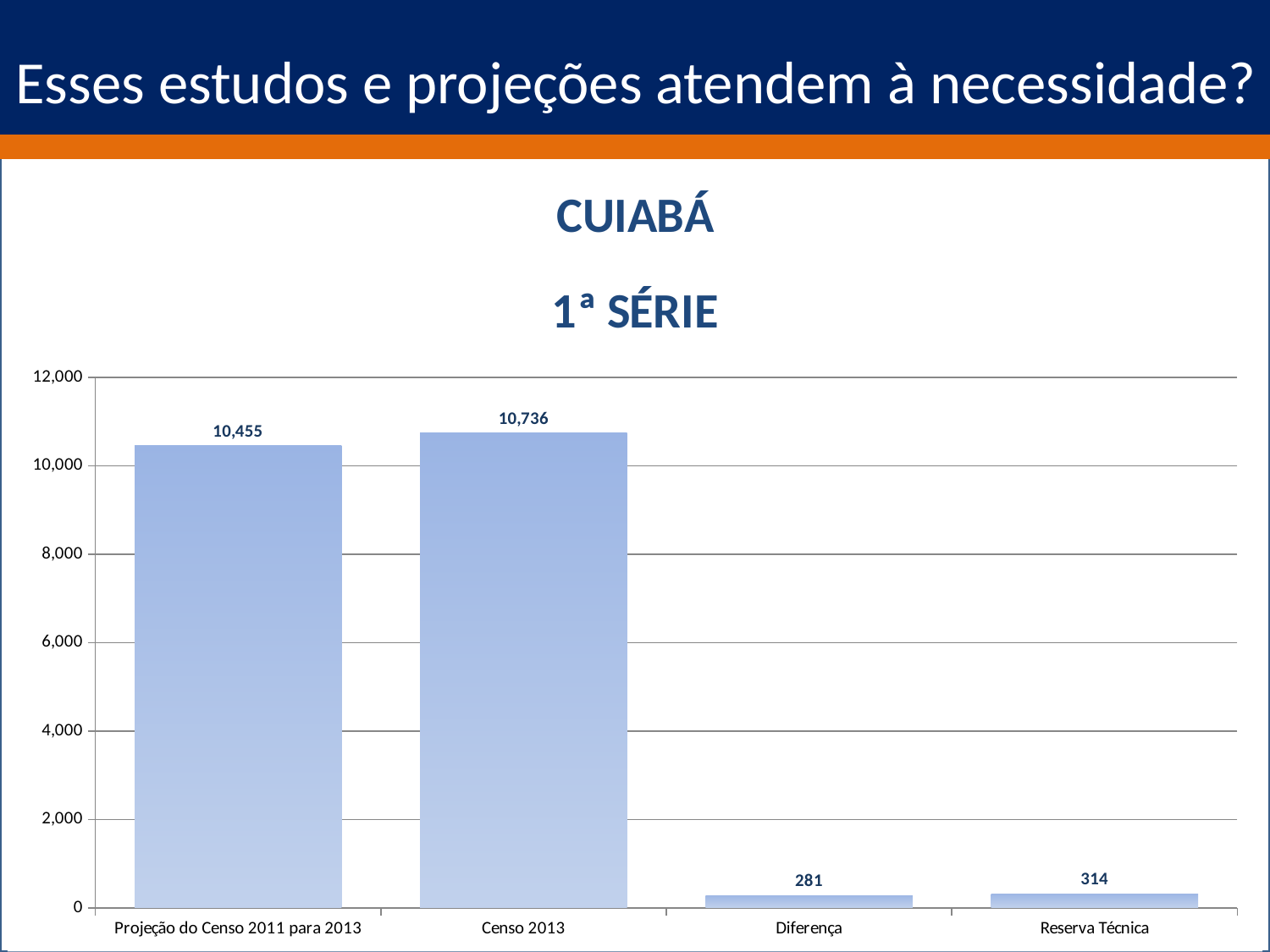
Is the value for Censo 2013 greater or less than 10,000? greater Which category has the highest value? Censo 2013 Which category has the lowest value? Diferença What is the difference between Censo 2013 and Projeção do Censo 2011 para 2013? 281 What is the value for Diferença? 281 What is the value for Reserva Técnica? 314 What is the value for Projeção do Censo 2011 para 2013? 10,455 How many categories are shown on the x axis? 4 What kind of chart is shown on the slide? bar chart What is the title of the chart? 1ª SÉRIE Which is larger, Reserva Técnica or Diferença? Reserva Técnica What is the value for Censo 2013? 10,736